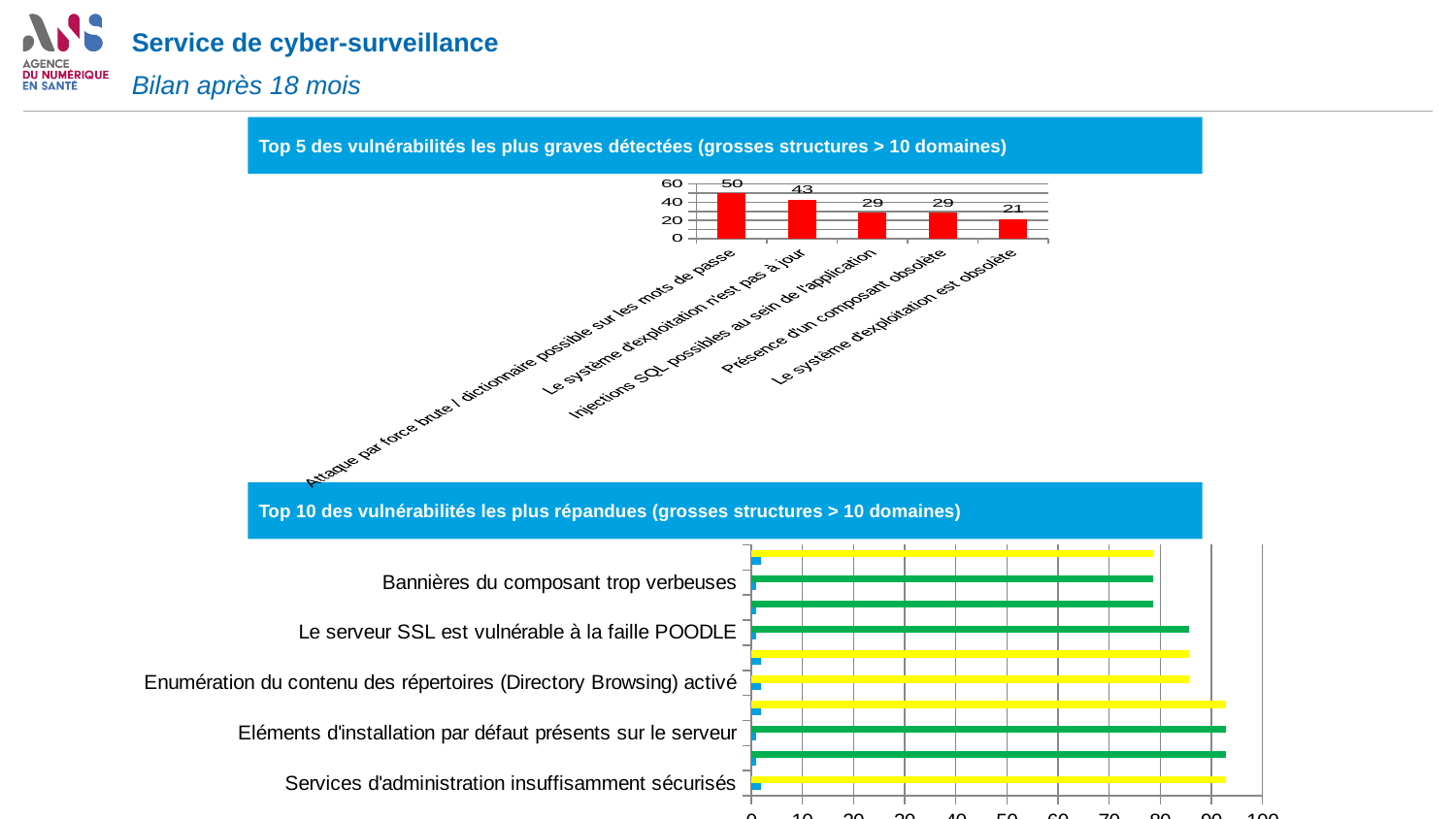
What colour are the bars in the chart 'Top 5 des vulnérabilités les plus graves détectées'? red In the chart 'Top 5 des vulnérabilités les plus graves détectées', which category has the highest value? Attaque par force brute / dictionnaire possible sur les mots de passe In the chart 'Top 5 des vulnérabilités les plus graves détectées', what is the value for 'Le système d'exploitation est obsolète'? 21 In the chart 'Top 5 des vulnérabilités les plus graves détectées', which category has the lowest value? Le système d'exploitation est obsolète In the chart 'Top 5 des vulnérabilités les plus graves détectées', do the values rise or fall from left to right? fall In the chart 'Top 10 des vulnérabilités les plus répandues', is the value for 'Bannières du composant trop verbeuses' greater or less than 90? less What kind of chart is the 'Top 10 des vulnérabilités les plus répandues' chart? bar chart In the chart 'Top 5 des vulnérabilités les plus graves détectées', what is the value for 'Le système d'exploitation n'est pas à jour'? 43 In the chart 'Top 5 des vulnérabilités les plus graves détectées', what is the value for 'Attaque par force brute / dictionnaire possible sur les mots de passe'? 50 In the chart 'Top 5 des vulnérabilités les plus graves détectées', what is the difference between the values for 'Attaque par force brute / dictionnaire possible sur les mots de passe' and 'Le système d'exploitation n'est pas à jour'? 7 In the chart 'Top 5 des vulnérabilités les plus graves détectées', how many categories are plotted? 5